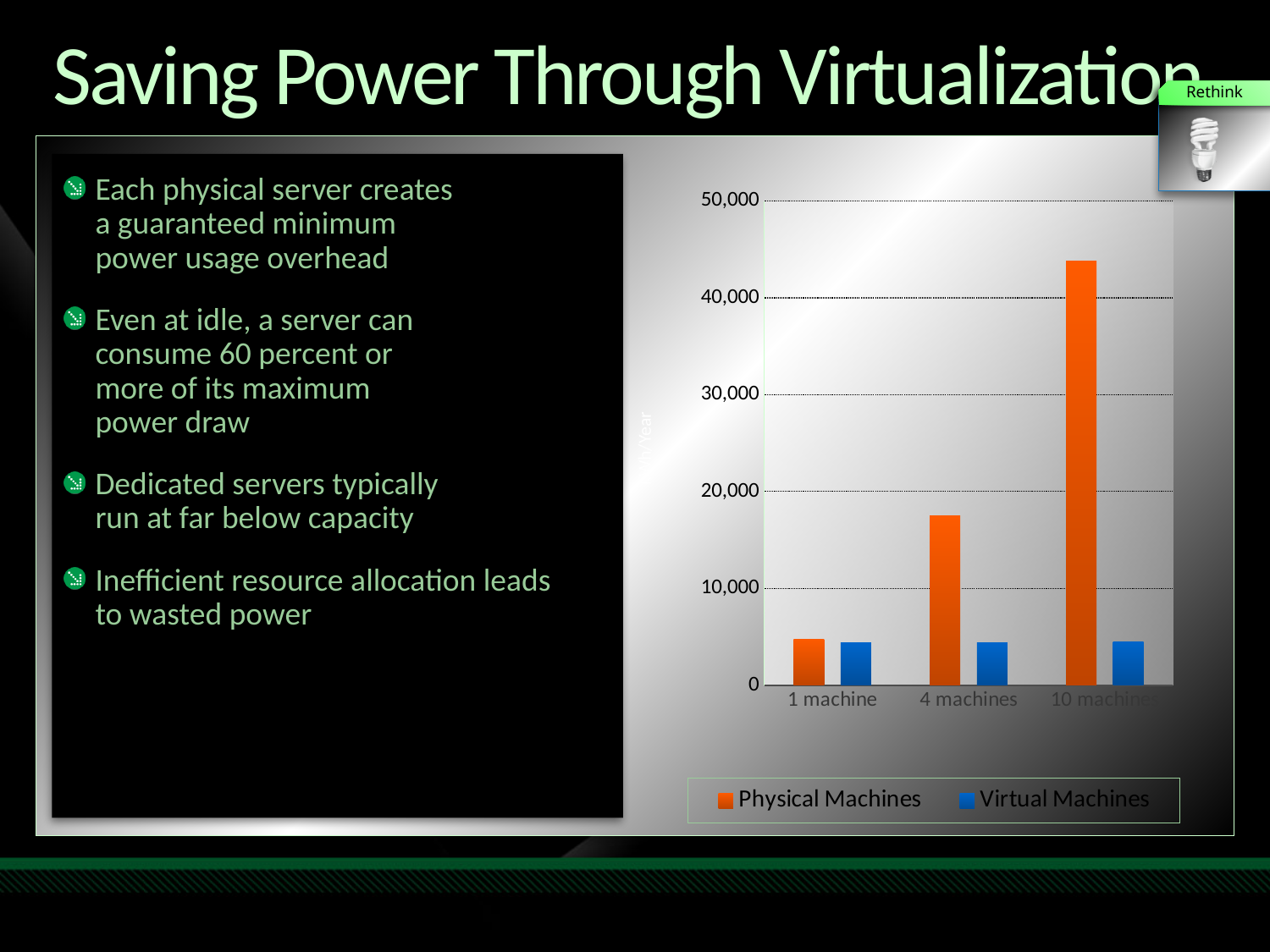
What kind of chart is shown on the slide? bar chart Is the Virtual Machines value for 10 machines greater or less than 10,000? less Is the Physical Machines value for 4 machines greater or less than 10,000? greater Is the Physical Machines value for 4 machines greater or less than 20,000? less What colour represents the Physical Machines series in the chart? orange For 4 machines, which is larger: Physical Machines or Virtual Machines? Physical Machines How many series does the chart legend list? 2 Which category has the highest Physical Machines value? 10 machines Do the Physical Machines values rise or fall from 1 machine to 10 machines? rise How many categories are shown on the x axis of the chart? 3 Which category has the lowest Physical Machines value? 1 machine